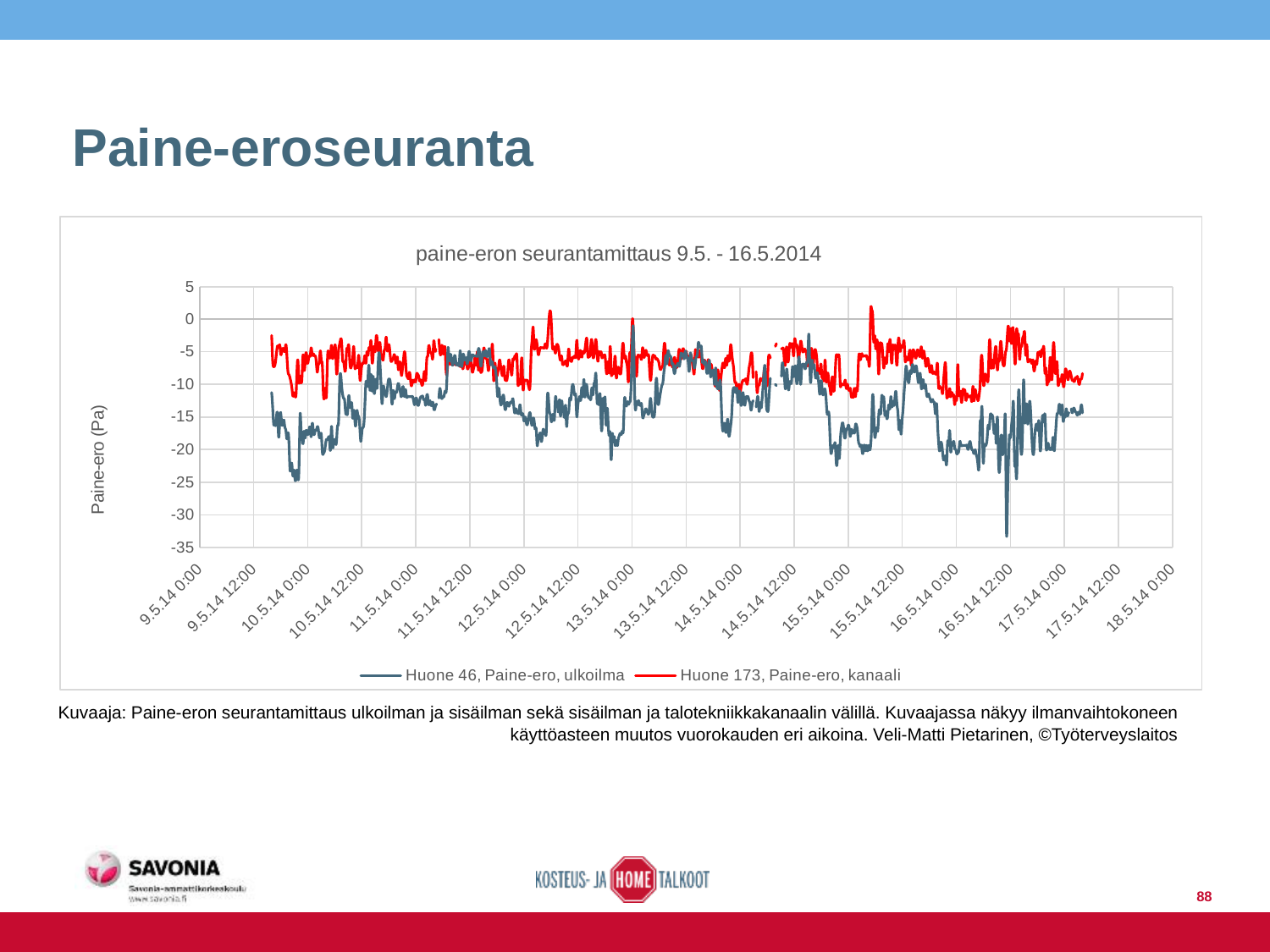
Which series generally has the higher (less negative) values, Huone 46 or Huone 173? Huone 173, Paine-ero, kanaali Is the value for Huone 46 at 10.5.14 0:00 greater or less than -15? less What is the lowest tick value shown on the vertical axis? -35 What is the title of the chart? paine-eron seurantamittaus 9.5. - 16.5.2014 Does the Huone 173 line ever drop below -15 Pa? no What kind of chart is shown on the slide? line chart What is the label of the vertical axis? Paine-ero (Pa) Does the Huone 46 line ever drop below -30 Pa? yes Which series reaches the lowest value on the chart? Huone 46, Paine-ero, ulkoilma How many series does the chart legend list? 2